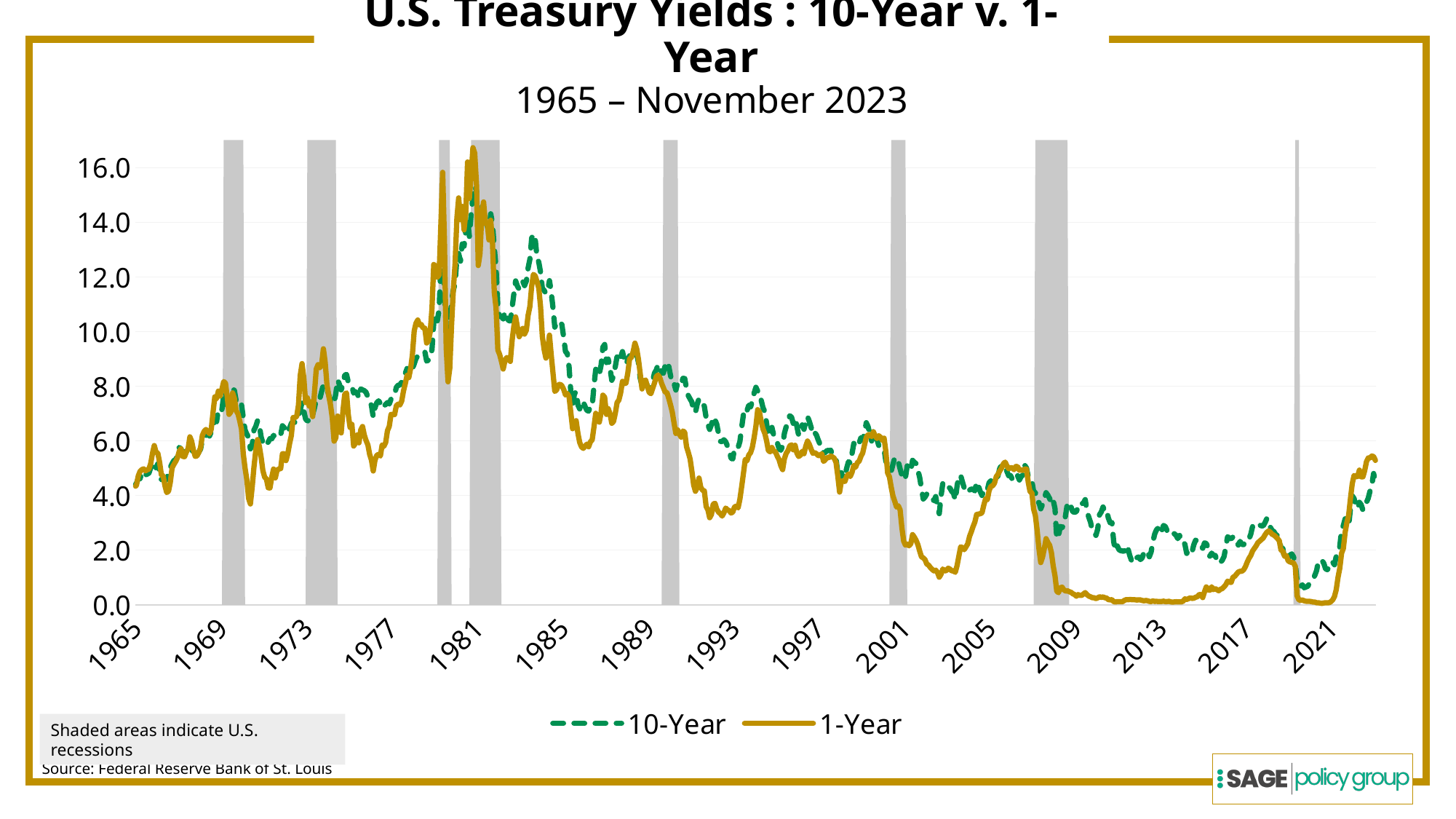
Is the peak of the 1-Year yield around 1981 greater or less than 14.0? greater Do yields generally rise or fall from their early-1980s peak through to around 2013? Fall What are the two series named in the legend? 10-Year and 1-Year How many series does the legend list? 2 Is the 10-Year yield around 1985 greater or less than 8.0? greater Around 2013, which series is higher, the 10-Year or the 1-Year? 10-Year Do the yields rise or fall from 2021 to the end of the chart? Rise What do the shaded areas on the chart indicate? U.S. recessions What kind of chart is shown on the slide? Line chart How many year labels are shown on the x axis? 15 Is the 1-Year yield around 2013 greater or less than 2.0? less